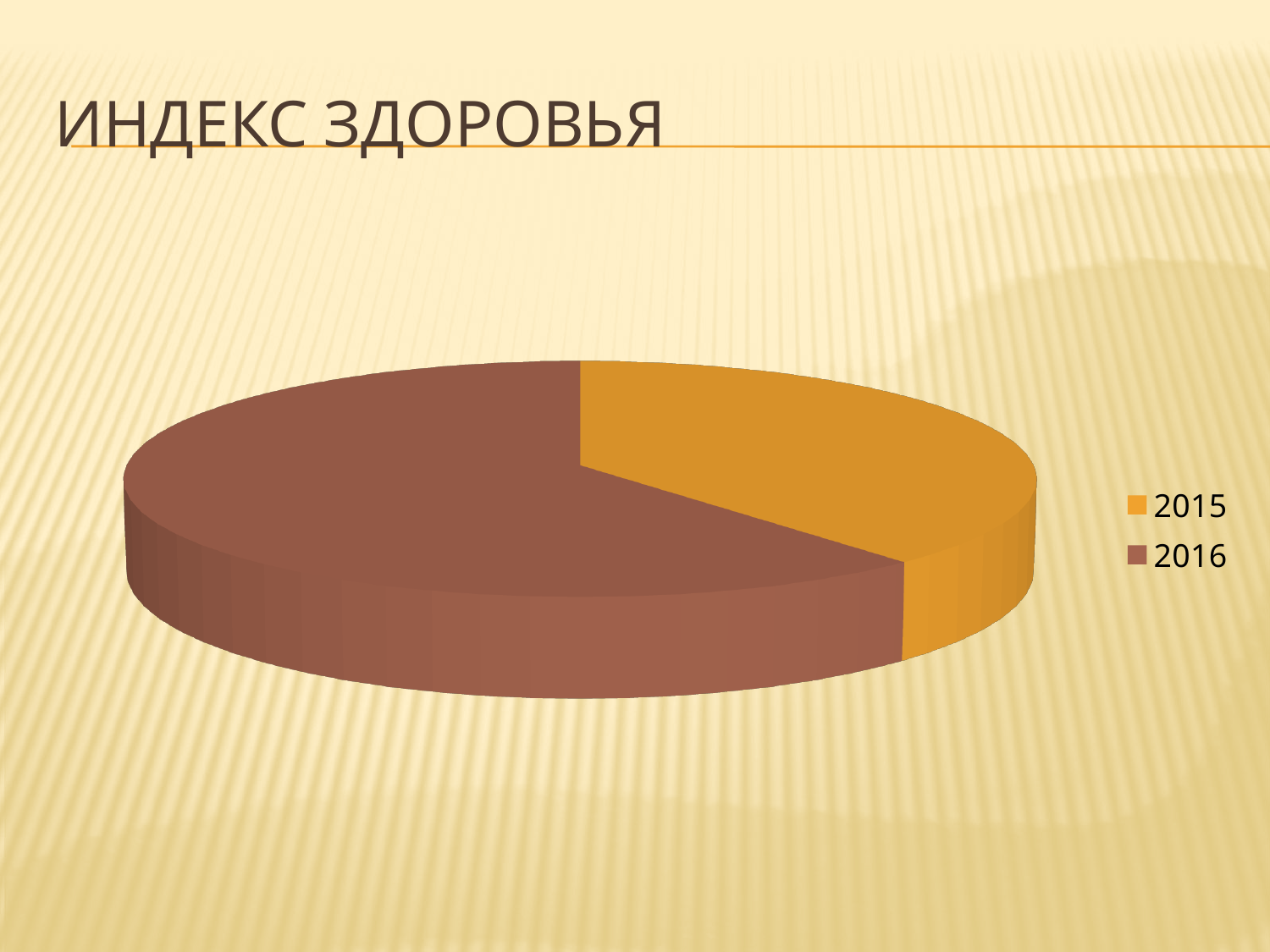
What colour is the slice for 2016 in the pie chart? brown Which category has the smallest slice of the pie? 2015 Which slice is larger, 2015 or 2016? 2016 What is the title of the slide containing the chart? ИНДЕКС ЗДОРОВЬЯ How many slices does the pie chart have? 2 What kind of chart is shown on the slide? pie chart Which category has the largest slice of the pie? 2016 How many entries does the legend list? 2